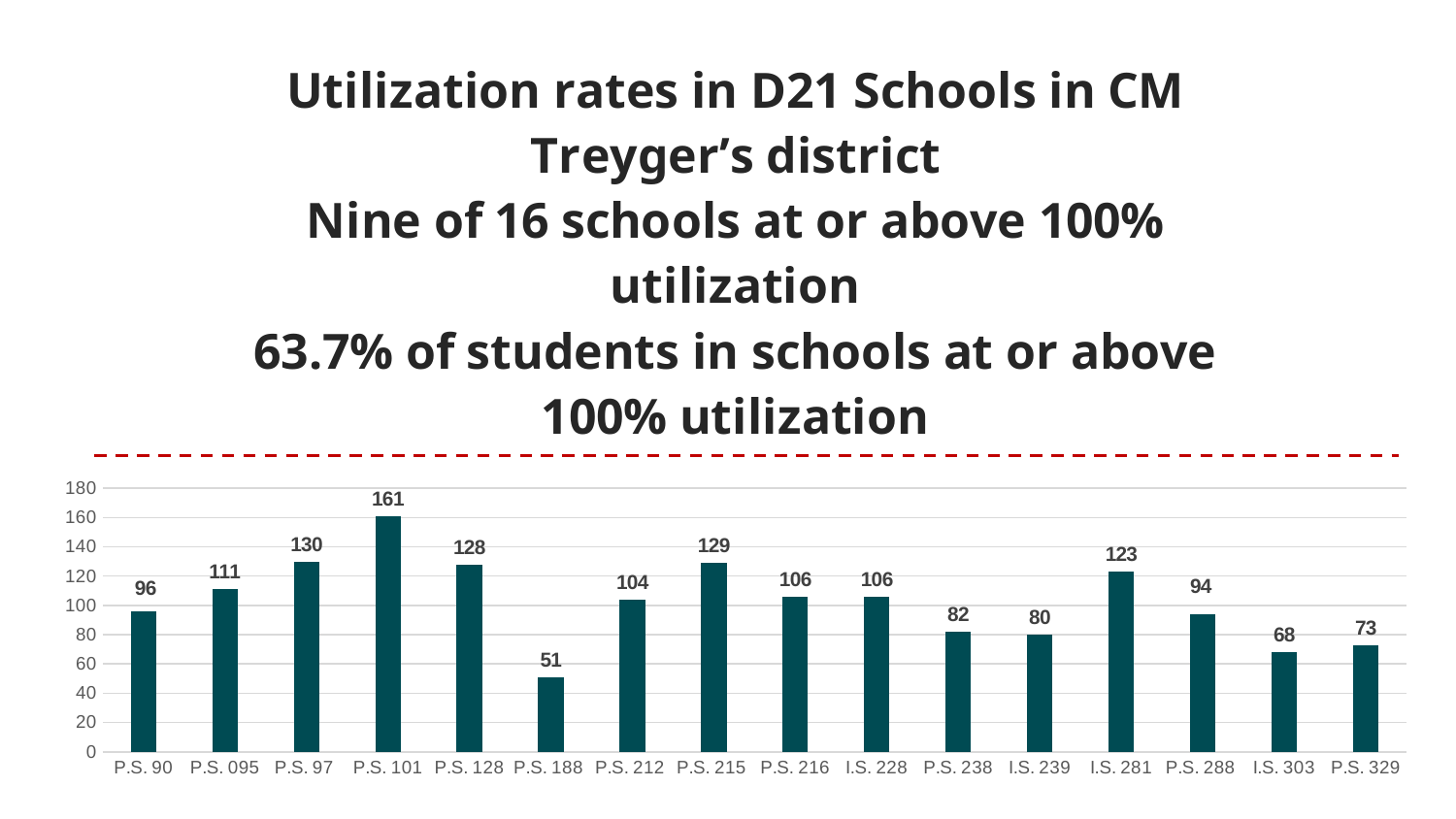
Which school has the lowest utilization rate? P.S. 188 How many schools are shown on the chart? 16 Which school has the highest utilization rate? P.S. 101 What kind of chart is shown on the slide? Bar chart What is the utilization rate for P.S. 188? 51 Which has a higher utilization rate, P.S. 97 or P.S. 128? P.S. 97 What is the utilization rate for P.S. 101? 161 What is the highest value shown on the vertical axis? 180 Is the utilization rate for P.S. 238 greater or less than 100? less What is the difference between the utilization rates of P.S. 288 and I.S. 303? 26 What is the difference between the utilization rates of P.S. 101 and P.S. 188? 110 What is the utilization rate for I.S. 281? 123